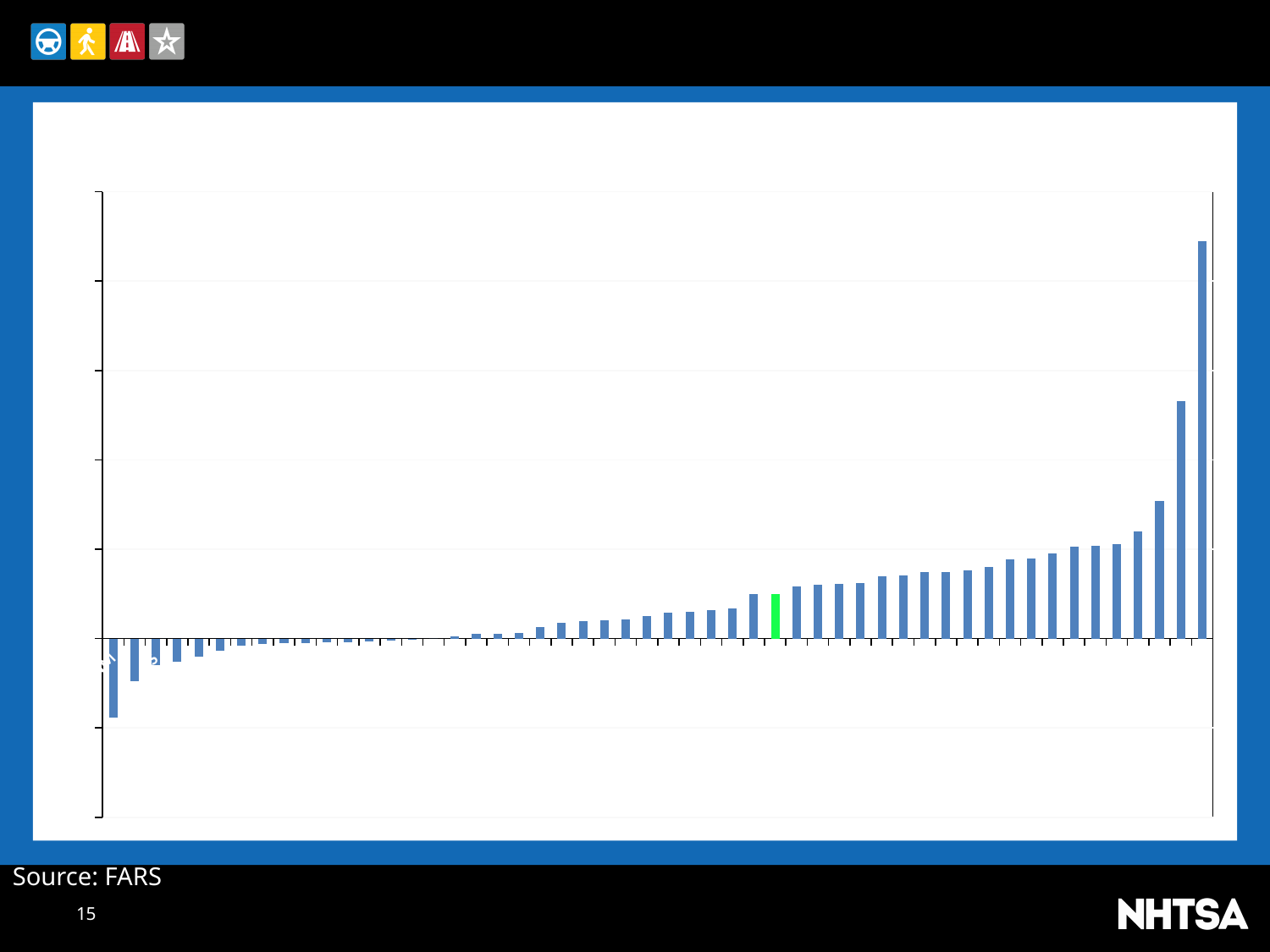
Is the tallest bar at the left end or the right end of the chart? right end What source is cited below the chart? FARS How many bars in the chart are coloured green rather than blue? 1 Do the bar values generally rise or fall moving from left to right along the x axis? rise Is the lowest (most negative) bar at the left end or the right end of the chart? left end What kind of chart is shown on the slide? bar chart